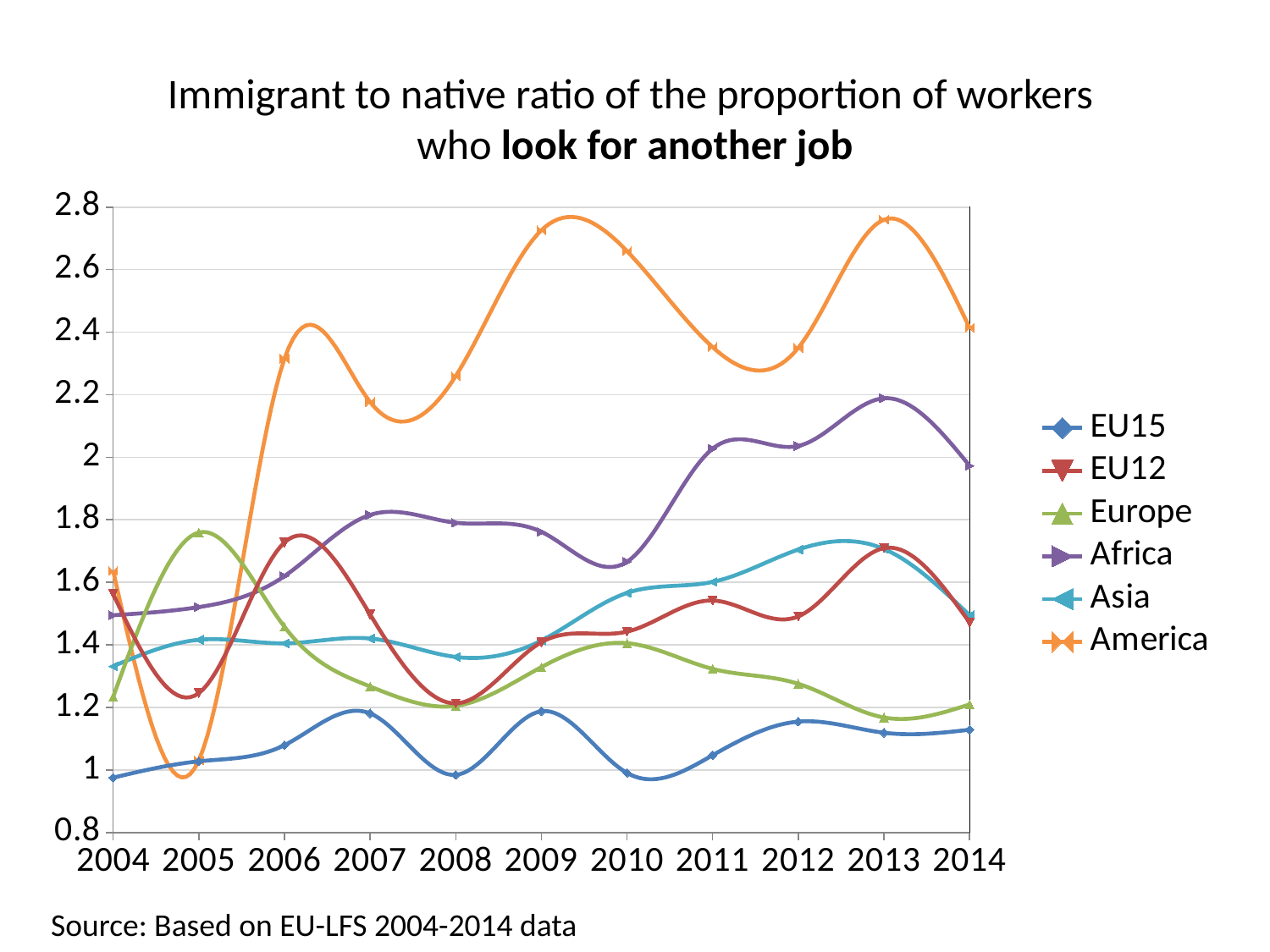
In 2012, which is larger: the value for Africa or the value for EU12? Africa What data source is cited below the chart? Based on EU-LFS 2004-2014 data How many series does the legend list? 6 How many years are plotted along the x axis? 11 Does the Africa series rise or fall between 2010 and 2013? rises Is the value for America in 2009 greater or less than 2.6? greater Which series has the lowest value in 2004? EU15 Is the value for Africa in 2013 greater or less than 2? greater Which series has the lowest value in 2010? EU15 Is the value for EU15 in 2008 greater or less than 1.2? less Which series has the highest value in 2013? America What kind of chart is shown on the slide? line chart